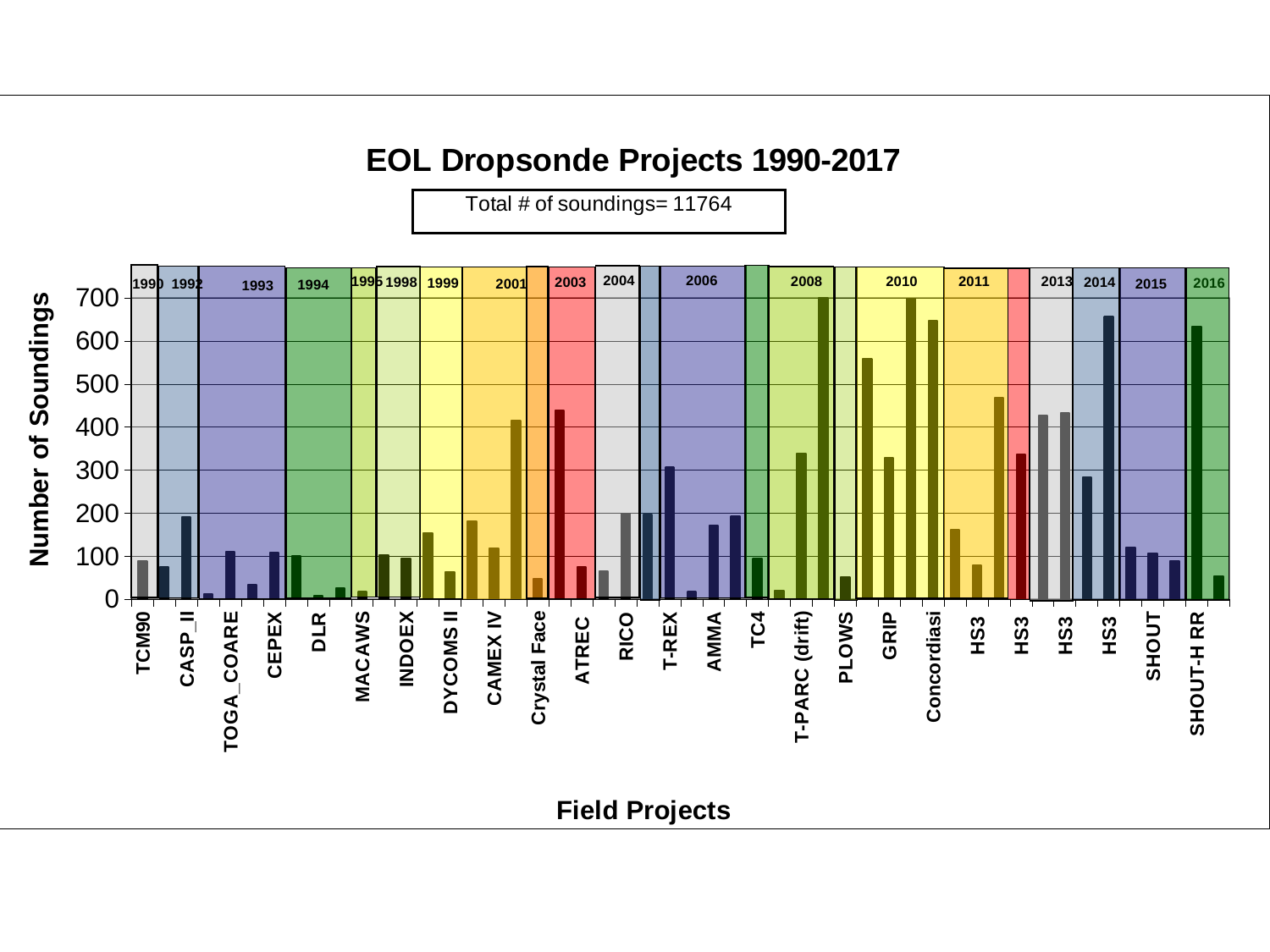
Which has the larger value, Crystal Face or DYCOMS II? DYCOMS II Is the value for Concordiasi greater or less than 600? greater Is the value for GRIP greater or less than 500? less Is the value for PLOWS greater or less than 100? less Which has the larger value, ATREC or T-PARC (drift)? T-PARC (drift) What total number of soundings is stated in the box below the chart title? 11764 What is the title of the chart? EOL Dropsonde Projects 1990-2017 What kind of chart is shown on the slide? bar chart